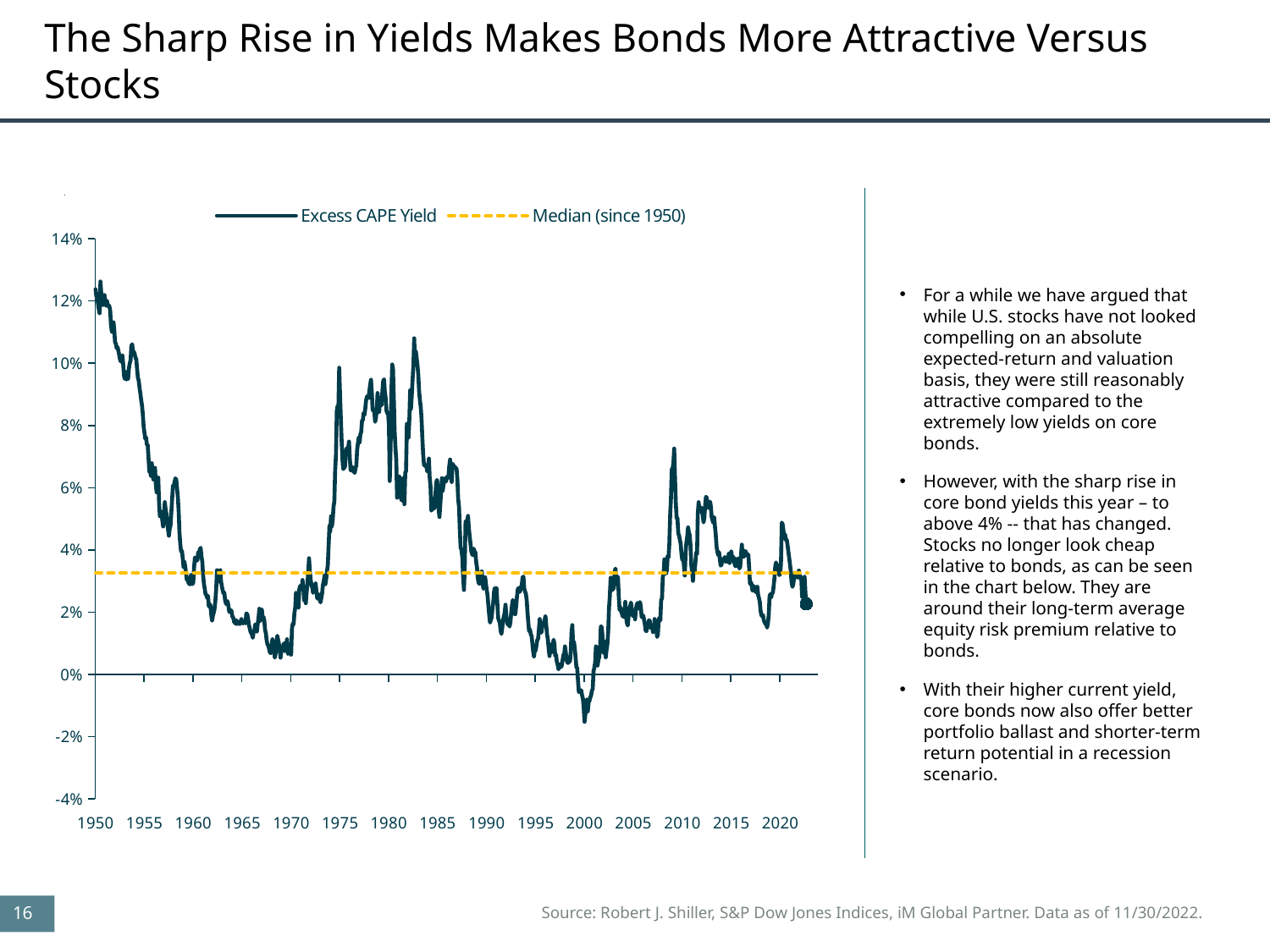
What are the two series named in the chart legend? Excess CAPE Yield and Median (since 1950) Is the Excess CAPE Yield at the start of the chart in 1950 greater or less than 10%? greater Does the Excess CAPE Yield rise or fall between 1950 and 1965? fall How many series does the chart legend list? 2 Is the Median (since 1950) line greater or less than 2%? greater Which is higher: the Excess CAPE Yield in 1950 or in 1965? 1950 Is the Excess CAPE Yield around the year 2000 greater or less than 0%? less Which series is drawn as a dashed line in the chart? Median (since 1950) What kind of chart is shown on the slide? Line chart Around which year does the Excess CAPE Yield reach its lowest point on the chart? 2000